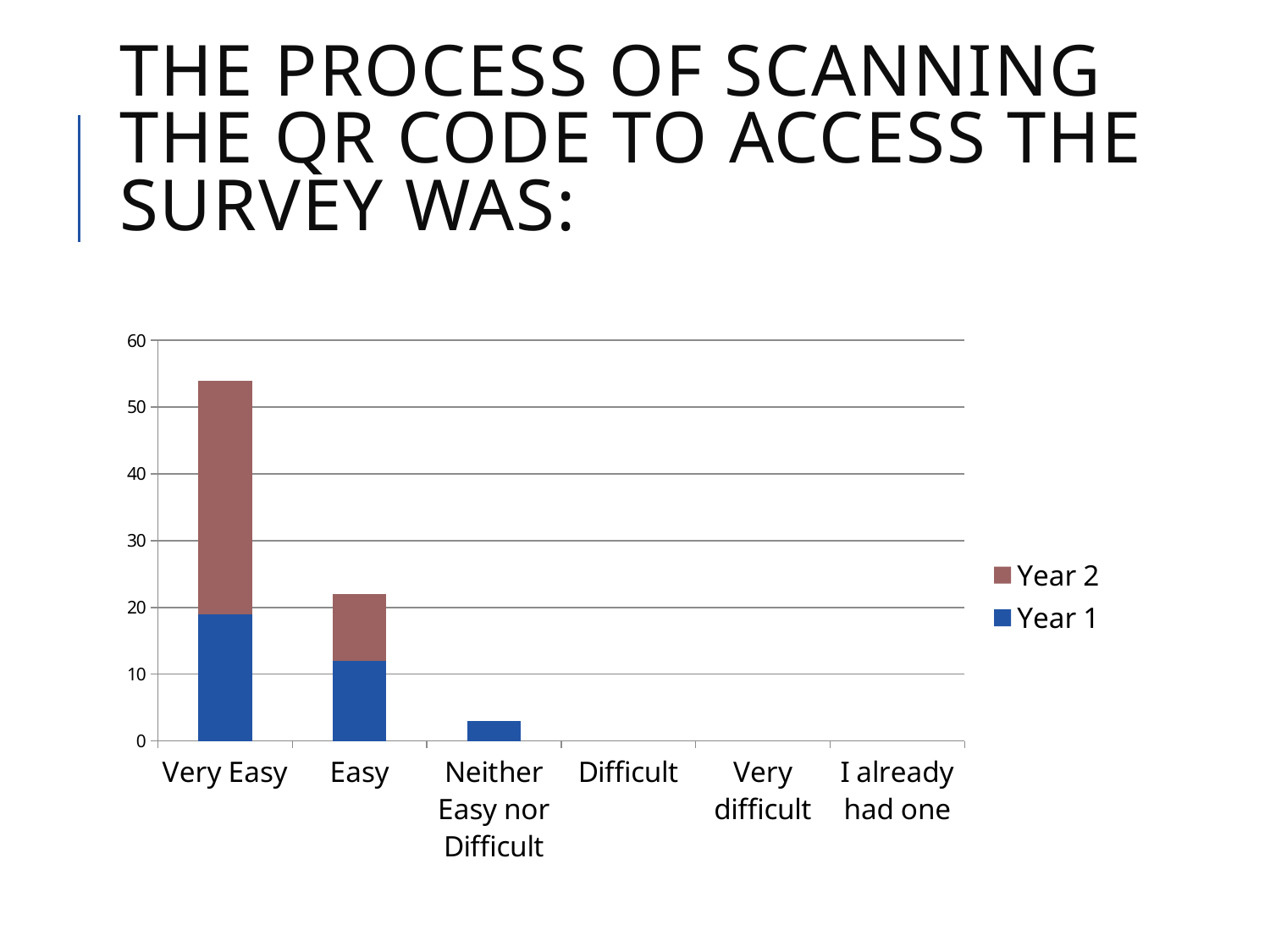
Which series are listed in the legend? Year 2 and Year 1 Is the Year 1 value for Easy greater or less than 20? less Is the value for Neither Easy nor Difficult greater or less than 10? less Which category has the tallest stacked bar? Very Easy Is the Year 1 value for Very Easy greater or less than 10? greater Which colour represents Year 1 in the chart? Blue What kind of chart is shown on the slide? Stacked bar chart Which is larger, the total stacked bar for Very Easy or for Easy? Very Easy How many series does the legend list? 2 How many categories are shown on the x axis? 6